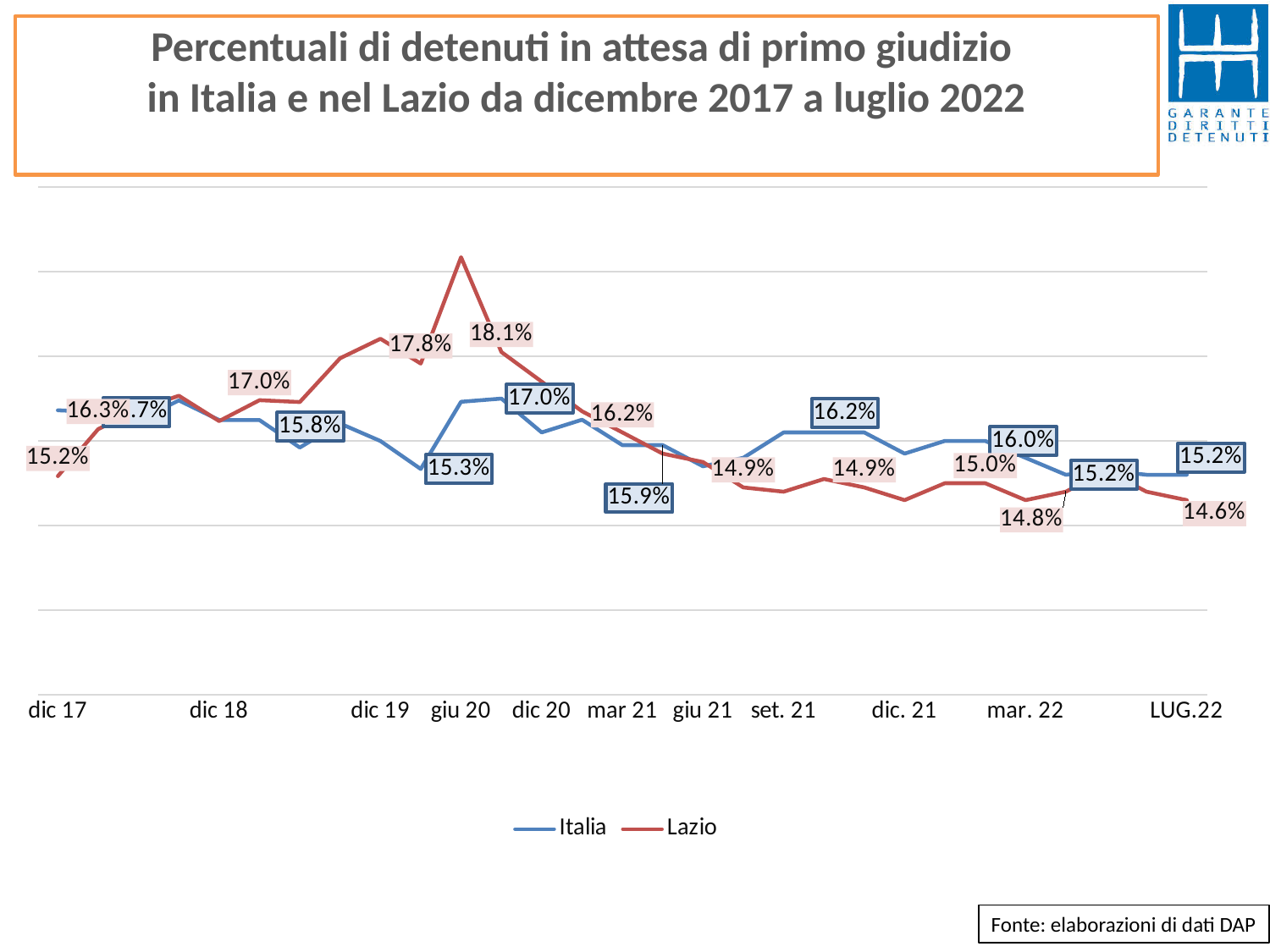
At LUG.22, how much higher is Italia than Lazio? 0.6 percentage points What is the value for Italia at LUG.22? 15.2% What source is cited at the bottom of the slide? Fonte: elaborazioni di dati DAP What is the value for Lazio at LUG.22? 14.6% At LUG.22, which series has the higher value, Italia or Lazio? Italia What kind of chart is shown on the slide? line chart What is the highest labelled value for the Italia series? 17.0% Does the Lazio line rise or fall from its peak at giu 20 to LUG.22? fall What is the highest labelled value for the Lazio series? 18.1% How many series does the legend list? 2 What are the two series named in the legend? Italia and Lazio